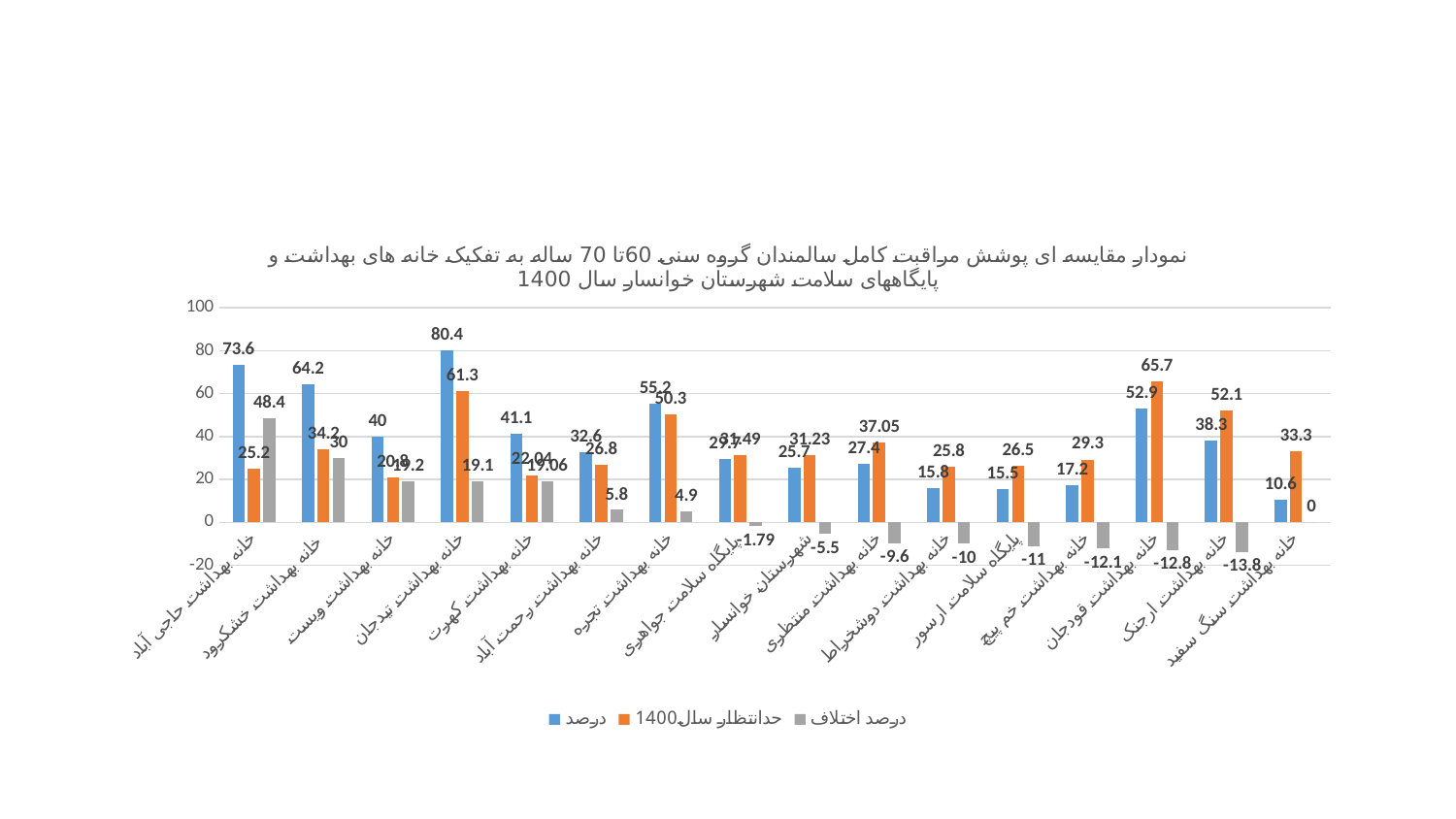
Which category has the lowest value in the blue 'درصد' series? خانه بهداشت سنگ سفید Which is larger for خانه بهداشت تجره: the blue 'درصد' value or the orange 'حدانتظار سال1400' value? the blue 'درصد' value Which category has the highest value in the blue 'درصد' series? خانه بهداشت تیدجان What is the value of the blue 'درصد' series for خانه بهداشت حاجی آباد? 73.6 What is the value of the orange 'حدانتظار سال1400' series for خانه بهداشت قودجان? 65.7 What is the difference between the blue 'درصد' value and the orange 'حدانتظار سال1400' value for خانه بهداشت حاجی آباد? 48.4 What is the value of the gray 'درصد اختلاف' series for خانه بهداشت ارجنک? -13.8 How many series does the legend list? 3 Is the blue 'درصد' value for خانه بهداشت خشکرود greater or less than 60? greater What colour represents the 'حدانتظار سال1400' series in the chart? orange What type of chart is shown on the slide? bar chart How many categories (health houses/centres) are shown on the x axis? 16